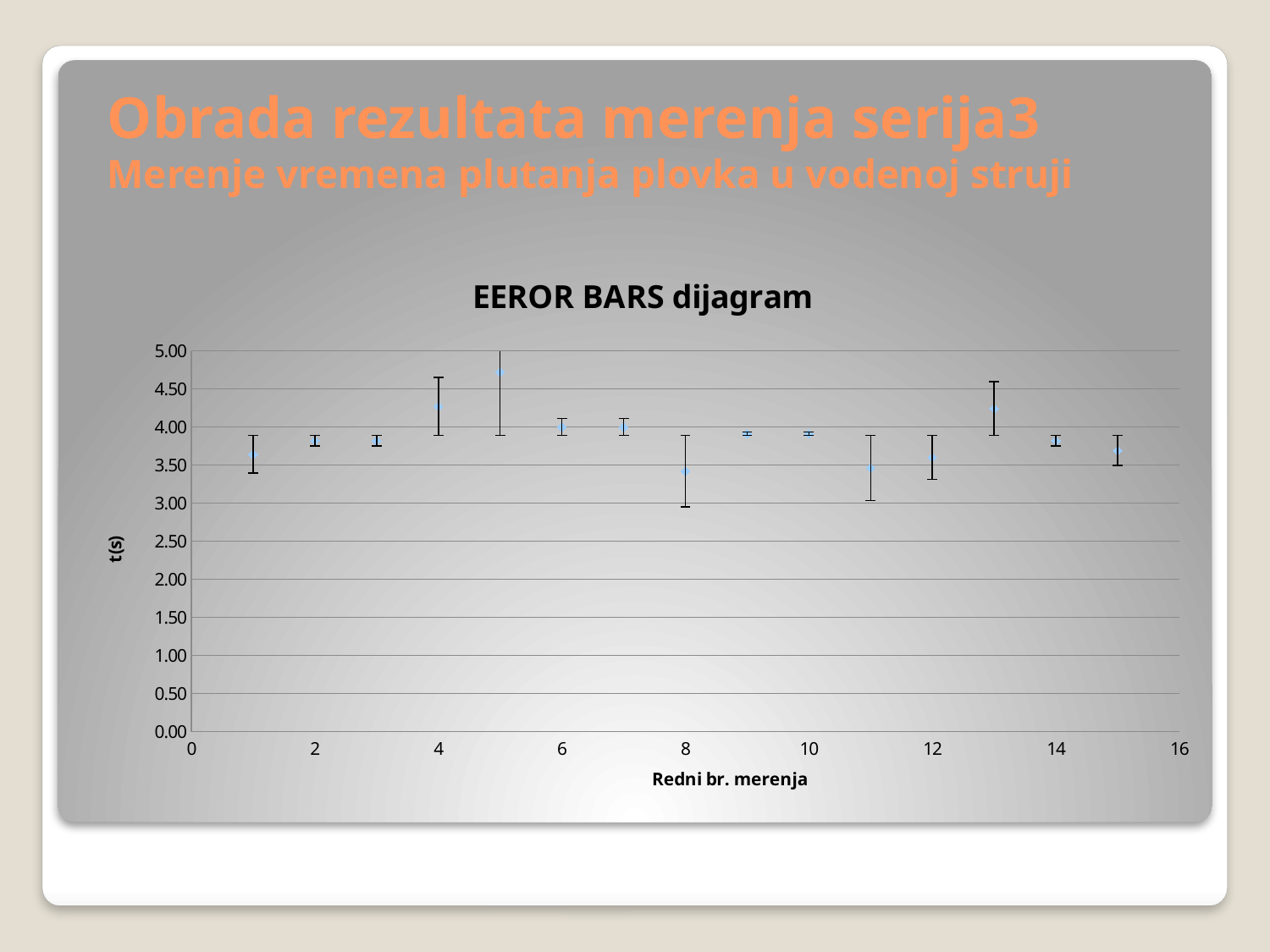
Is the value for measurement 4 greater or less than 4.00? greater Is the value for measurement 13 greater or less than 4.00? greater What is the label of the vertical axis? t(s) Which measurement number (Redni br. merenja) has the highest value of t(s)? 5 What kind of chart is shown on the slide? Scatter chart with error bars Is the value for measurement 1 greater or less than 4.00? less Which has the larger value of t(s): measurement 4 or measurement 1? Measurement 4 What is the title of the chart? EEROR BARS dijagram How many measurement points are plotted in the chart? 15 Which has the larger value of t(s): measurement 5 or measurement 8? Measurement 5